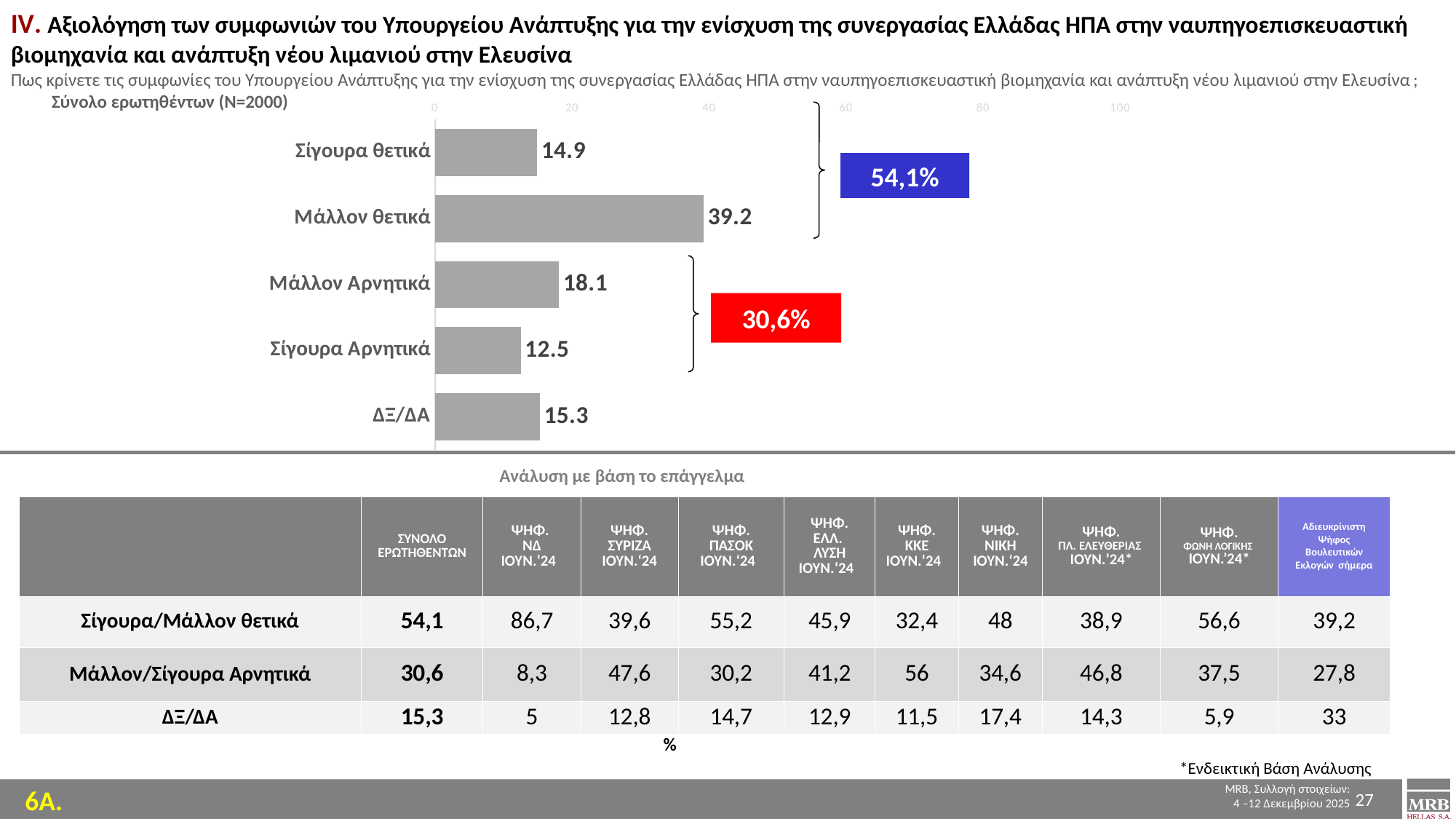
Which category has the lowest value in the bar chart? Σίγουρα Αρνητικά What is the value for ΔΞ/ΔΑ in the bar chart? 15.3 Which is larger, the value for Μάλλον Αρνητικά or the value for ΔΞ/ΔΑ? Μάλλον Αρνητικά What is the value for Μάλλον θετικά in the bar chart? 39.2 What is the value for Σίγουρα θετικά in the bar chart? 14.9 What combined percentage is shown in the blue box next to the positive bars? 54,1% What is the value for Σίγουρα Αρνητικά in the bar chart? 12.5 What kind of chart is shown on the slide? bar chart Which category has the highest value in the bar chart? Μάλλον θετικά Is the value for Μάλλον θετικά greater or less than 20? greater What is the difference between the values for Μάλλον θετικά and Μάλλον Αρνητικά? 21.1 How many categories are shown in the bar chart? 5